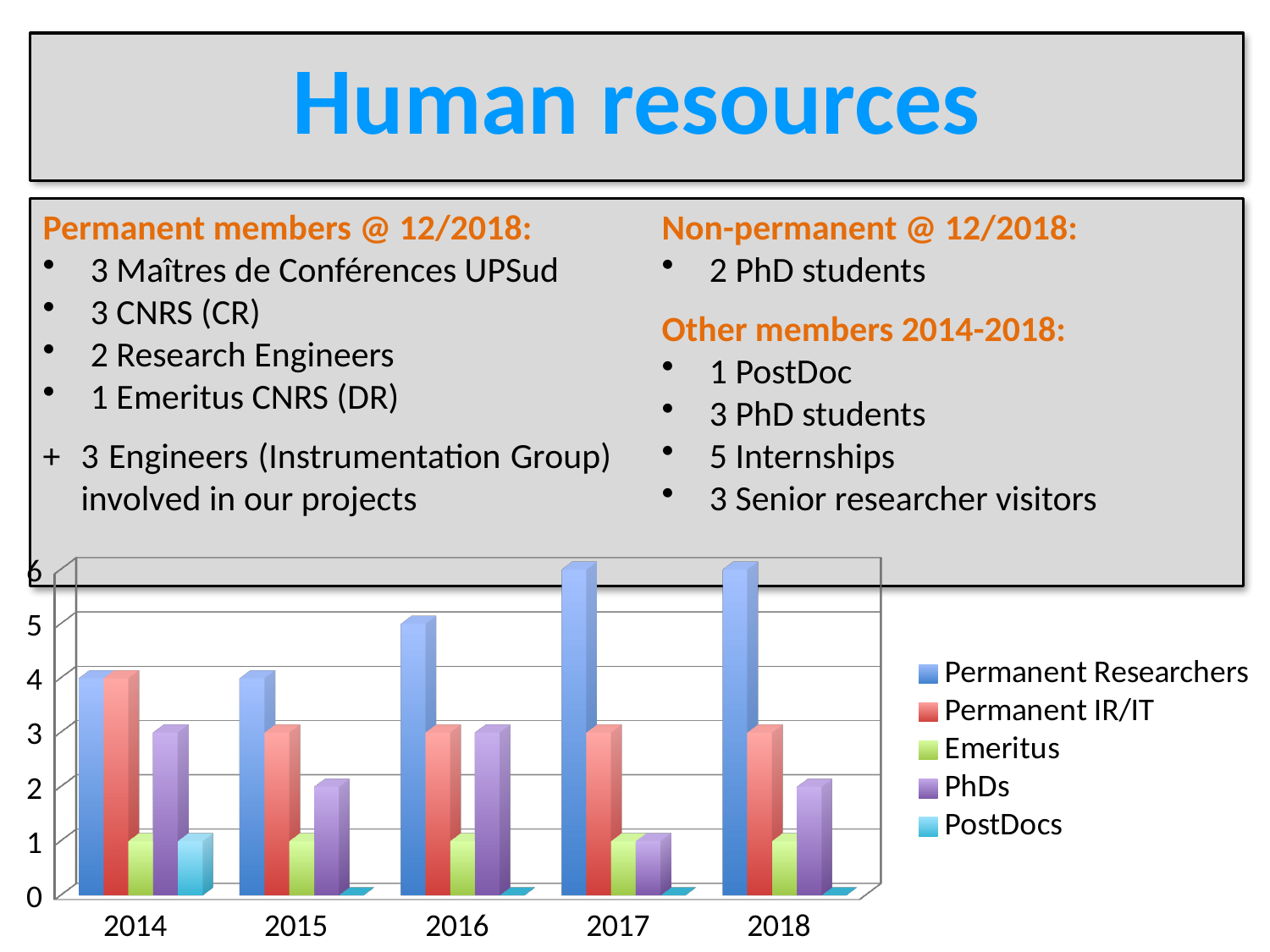
What is the value for Permanent Researchers in 2014? 4 What is the value for Permanent Researchers in 2017? 6 Which series is shown in light blue in the chart legend? PostDocs In which year is the Permanent Researchers value lowest? 2014 and 2015 Is the value for Permanent Researchers in 2018 greater or less than 5? greater How many series does the chart legend list? 5 What is the value for PhDs in 2014? 3 How many years are shown on the x axis of the chart? 5 Do the Permanent Researchers values rise or fall from 2014 to 2018? rise Is the value for PhDs in 2017 greater or less than 2? less What kind of chart is shown on the slide? bar chart Which is larger in 2016, Permanent Researchers or Permanent IR/IT? Permanent Researchers